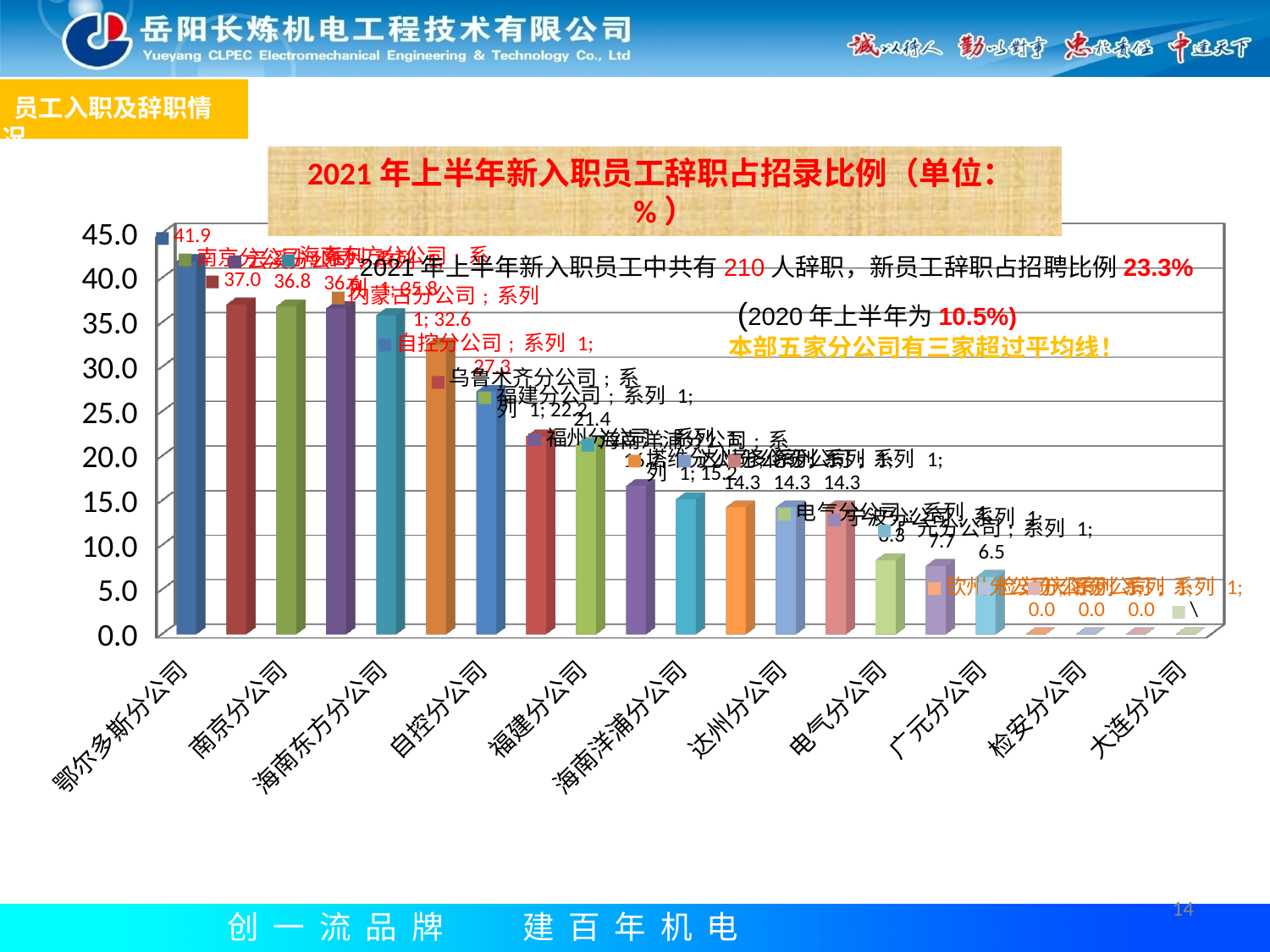
Which is larger, the value for 自控分公司 or the value for 电气分公司? 自控分公司 Which branch has the highest value in the chart? 鄂尔多斯分公司 Which is larger, the value for 鄂尔多斯分公司 or the value for 大连分公司? 鄂尔多斯分公司 What kind of chart is shown on the slide? bar chart Is the value for 广元分公司 greater or less than 10? less What is the title of the chart? 2021年上半年新入职员工辞职占招录比例（单位：%） Is the value for 自控分公司 greater or less than 25? greater What is the highest value labelled in the chart? 41.9 What is the value shown for 鄂尔多斯分公司? 41.9 Is the value for 大连分公司 greater or less than 5? less Do the bar values rise or fall from left to right along the x axis? fall